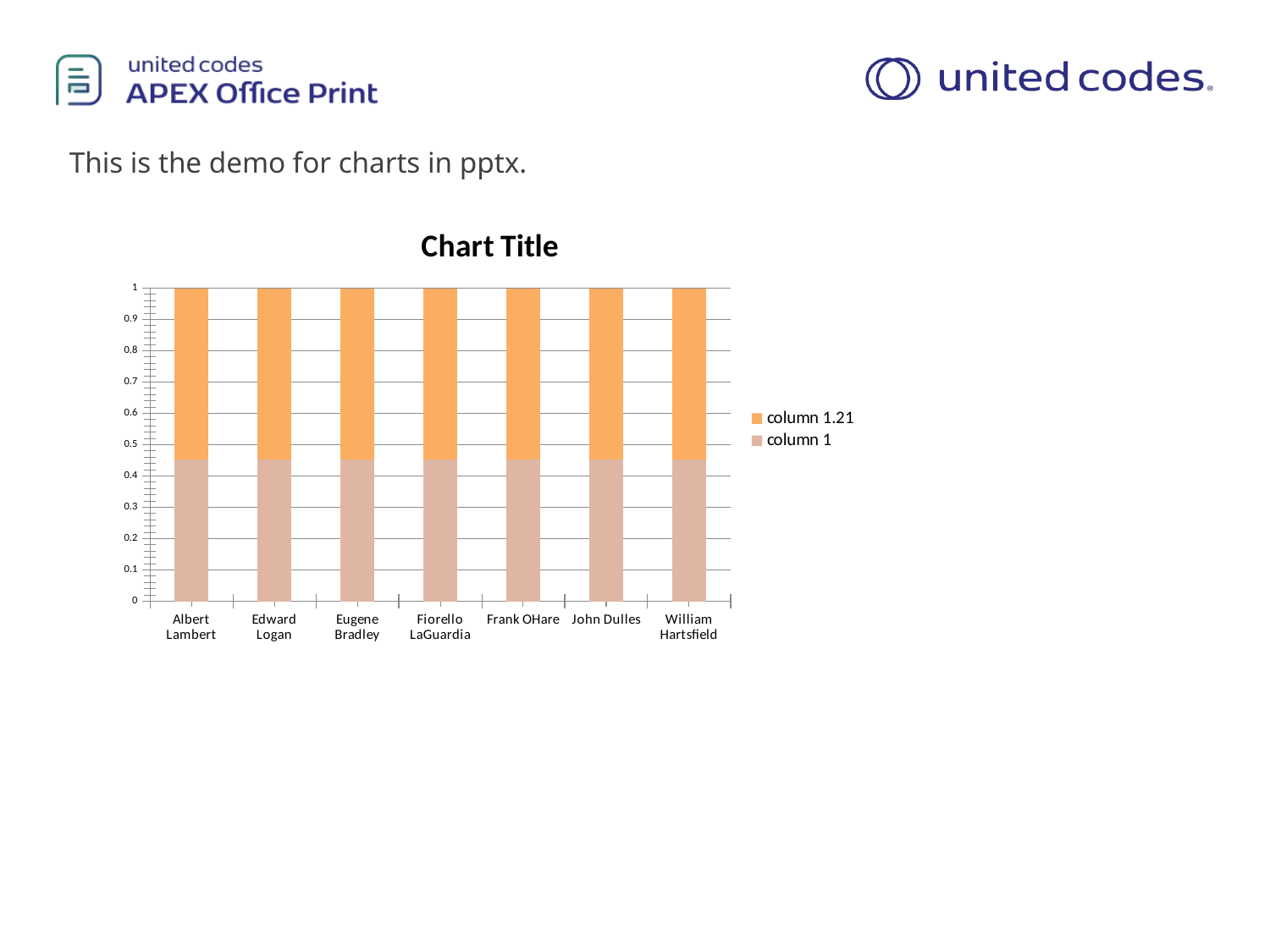
What kind of chart is shown on the slide? Stacked bar chart Is the value of column 1 for William Hartsfield greater or less than 0.6? less What is the total height of the stacked bar for John Dulles? 1 What are the two series names listed in the chart's legend? column 1.21 and column 1 How many series does the chart's legend list? 2 Is the value of column 1 for Edward Logan greater or less than 0.5? less What is the total height of the stacked bar for Albert Lambert? 1 Is the value of column 1 for Frank OHare greater or less than 0.4? greater Do the total heights of the stacked bars rise, fall, or stay the same from Albert Lambert to William Hartsfield? stay the same What is the highest value shown on the chart's vertical axis? 1 What is the title of the chart? Chart Title How many categories are shown on the x axis of the chart? 7